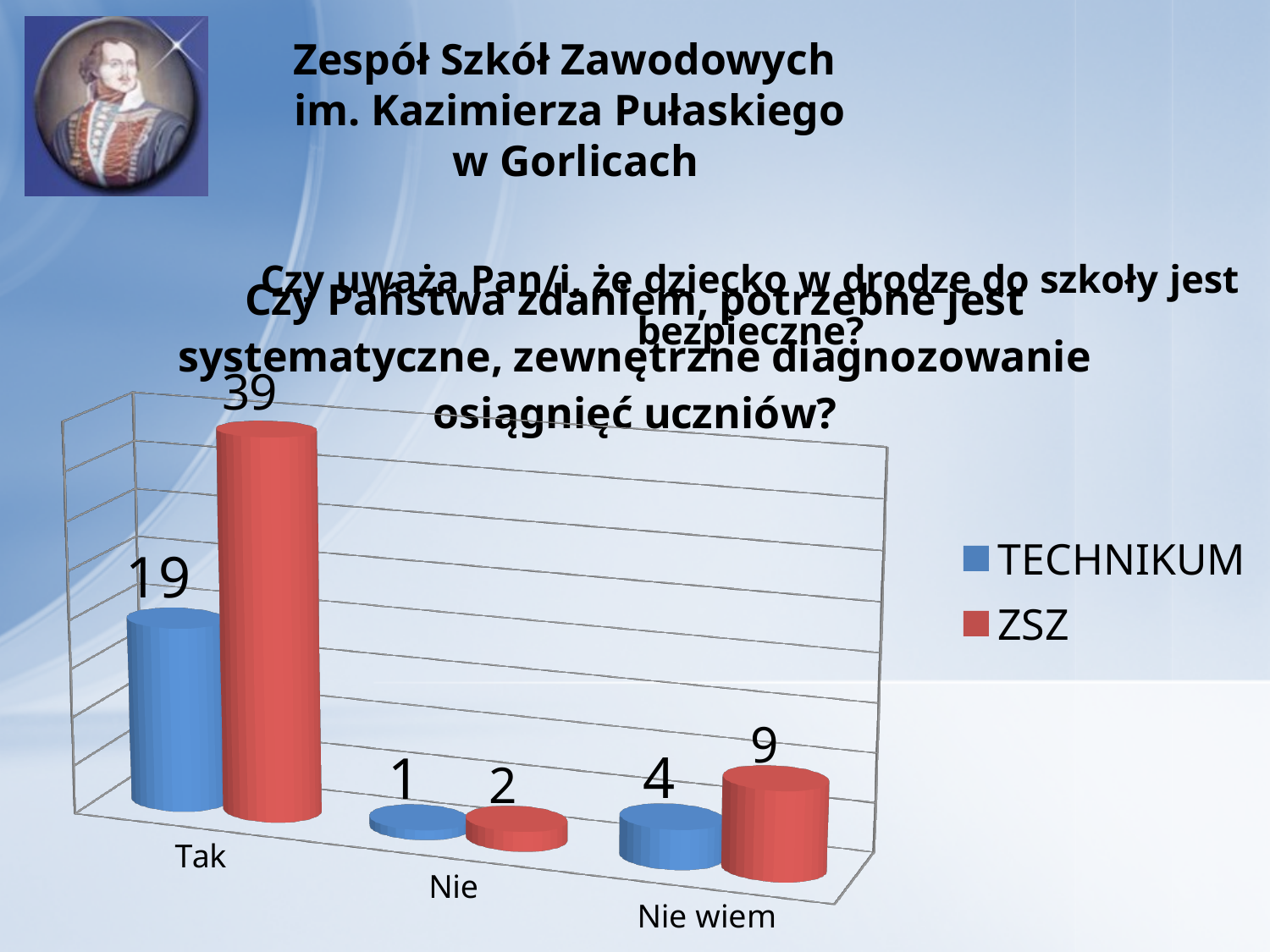
How many categories are shown on the x axis? 3 What is the value for TECHNIKUM in the Nie category? 1 Which category has the highest value for ZSZ? Tak What kind of chart is shown on the slide? Bar chart Which category has the lowest value for TECHNIKUM? Nie In the Nie wiem category, which series has the larger value, TECHNIKUM or ZSZ? ZSZ What is the value for ZSZ in the Tak category? 39 What is the value for ZSZ in the Nie wiem category? 9 What is the value for TECHNIKUM in the Tak category? 19 Which colour represents the ZSZ series in the legend? Red What is the difference between the ZSZ and TECHNIKUM values in the Tak category? 20 How many series does the legend list? 2